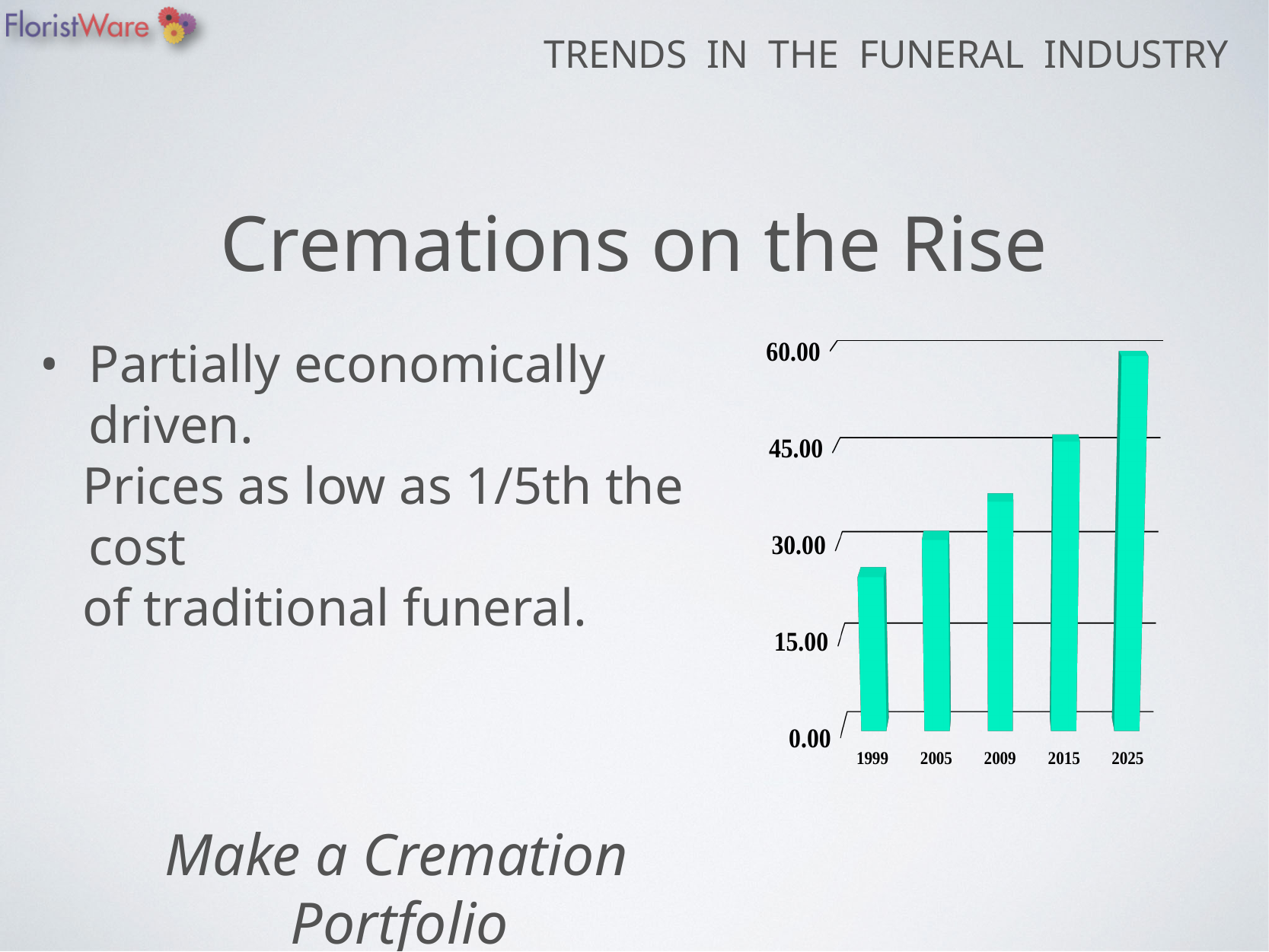
Do the bar values rise or fall from 1999 to 2025? rise How many years are shown on the x axis of the chart? 5 Is the value for 1999 greater or less than 30.00? less What kind of chart is shown on the slide? bar chart What is the first year shown on the chart's x axis? 1999 What is the highest value labelled on the chart's vertical axis? 60.00 Which year has the highest bar in the chart? 2025 Which is larger, the value for 2015 or the value for 2009? 2015 Which year has the lowest bar in the chart? 1999 Is the value for 2009 greater or less than 30.00? greater Is the value for 2009 greater or less than 45.00? less